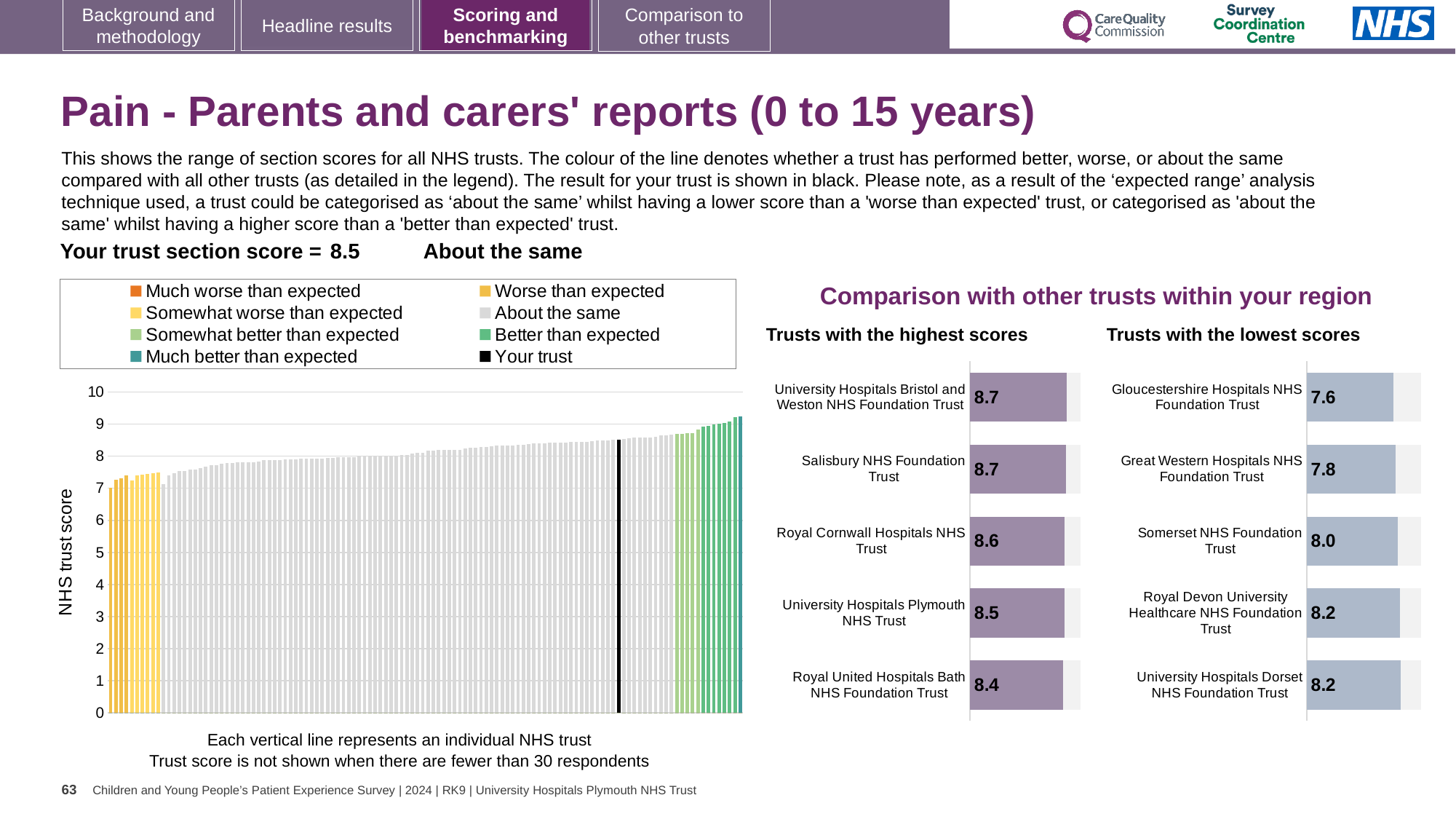
In the main chart on the left showing the range of section scores, is the value for the black 'Your trust' bar greater or less than 8? greater In the 'Trusts with the highest scores' chart, which trust has the lowest score shown? Royal United Hospitals Bath NHS Foundation Trust What kind of chart is the main chart on the left showing the range of section scores? bar chart In the main chart on the left, do the trust scores rise or fall from left to right? rise In the main chart on the left, is the value for the leftmost bar greater or less than 8? less In the 'Trusts with the highest scores' chart, what is the difference between the score for University Hospitals Bristol and Weston NHS Foundation Trust and the score for Royal United Hospitals Bath NHS Foundation Trust? 0.3 In the 'Trusts with the lowest scores' chart, what is the difference between the score for University Hospitals Dorset NHS Foundation Trust and the score for Gloucestershire Hospitals NHS Foundation Trust? 0.6 In the 'Trusts with the highest scores' chart, what is the score for Royal Cornwall Hospitals NHS Trust? 8.6 In the 'Trusts with the lowest scores' chart, which has the higher score: Great Western Hospitals NHS Foundation Trust or Somerset NHS Foundation Trust? Somerset NHS Foundation Trust In the 'Trusts with the lowest scores' chart, what is the score for Gloucestershire Hospitals NHS Foundation Trust? 7.6 In the 'Trusts with the lowest scores' chart, which trust has the lowest score? Gloucestershire Hospitals NHS Foundation Trust In the 'Trusts with the highest scores' chart, how many trusts are listed? 5